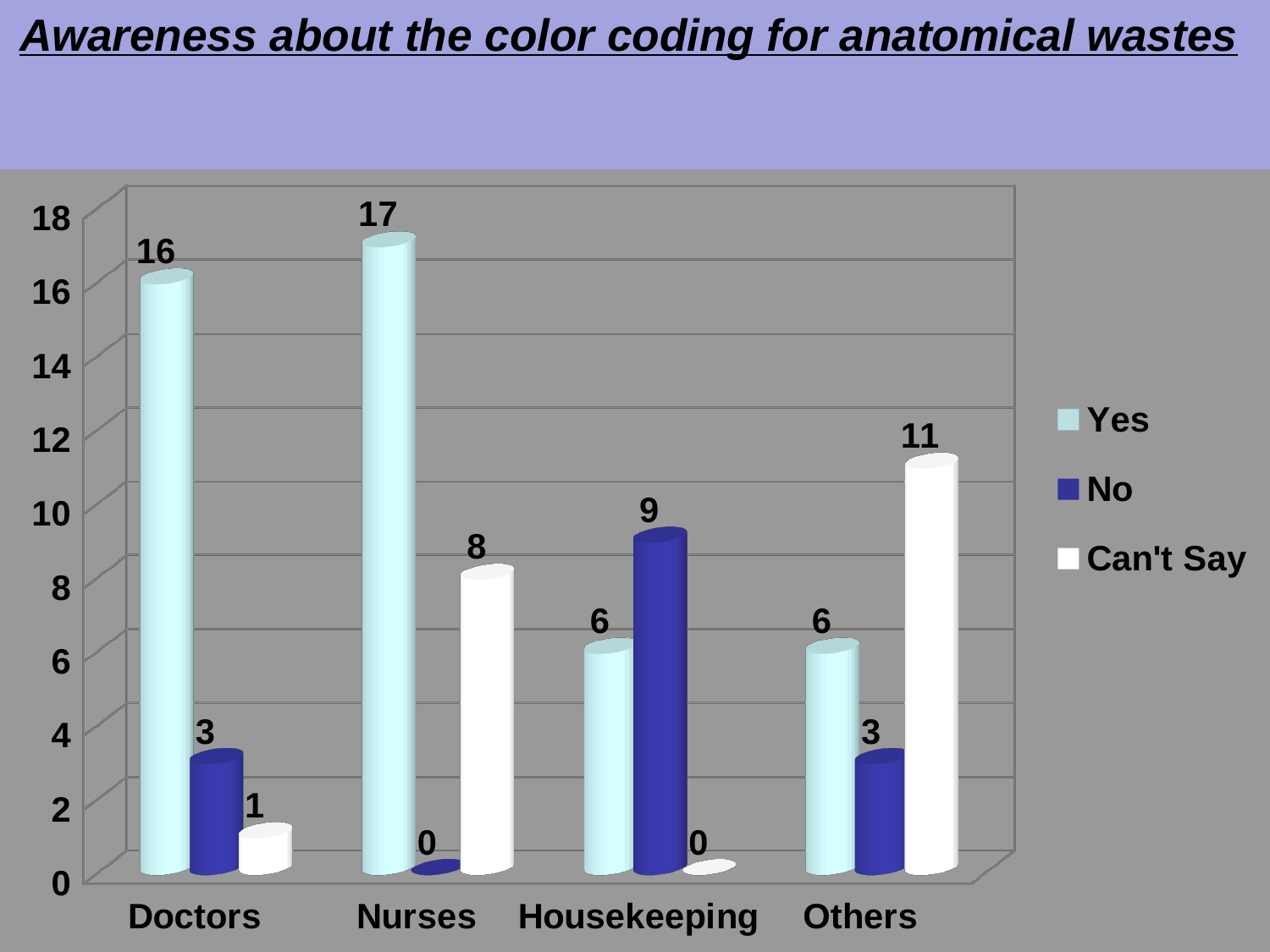
What is the value for No among Housekeeping? 9 Which category has the lowest Can't Say value? Housekeeping Which category has the highest Yes value? Nurses What kind of chart is shown on the slide? Bar chart What is the value for Can't Say among Others? 11 How many categories are shown on the x axis? 4 What is the total of the three values for Others? 20 How many series does the legend list? 3 What is the difference between the Yes values for Nurses and Doctors? 1 What is the title of the chart? Awareness about the color coding for anatomical wastes What is the value for Yes among Nurses? 17 Which is larger for Housekeeping, the Yes value or the No value? No